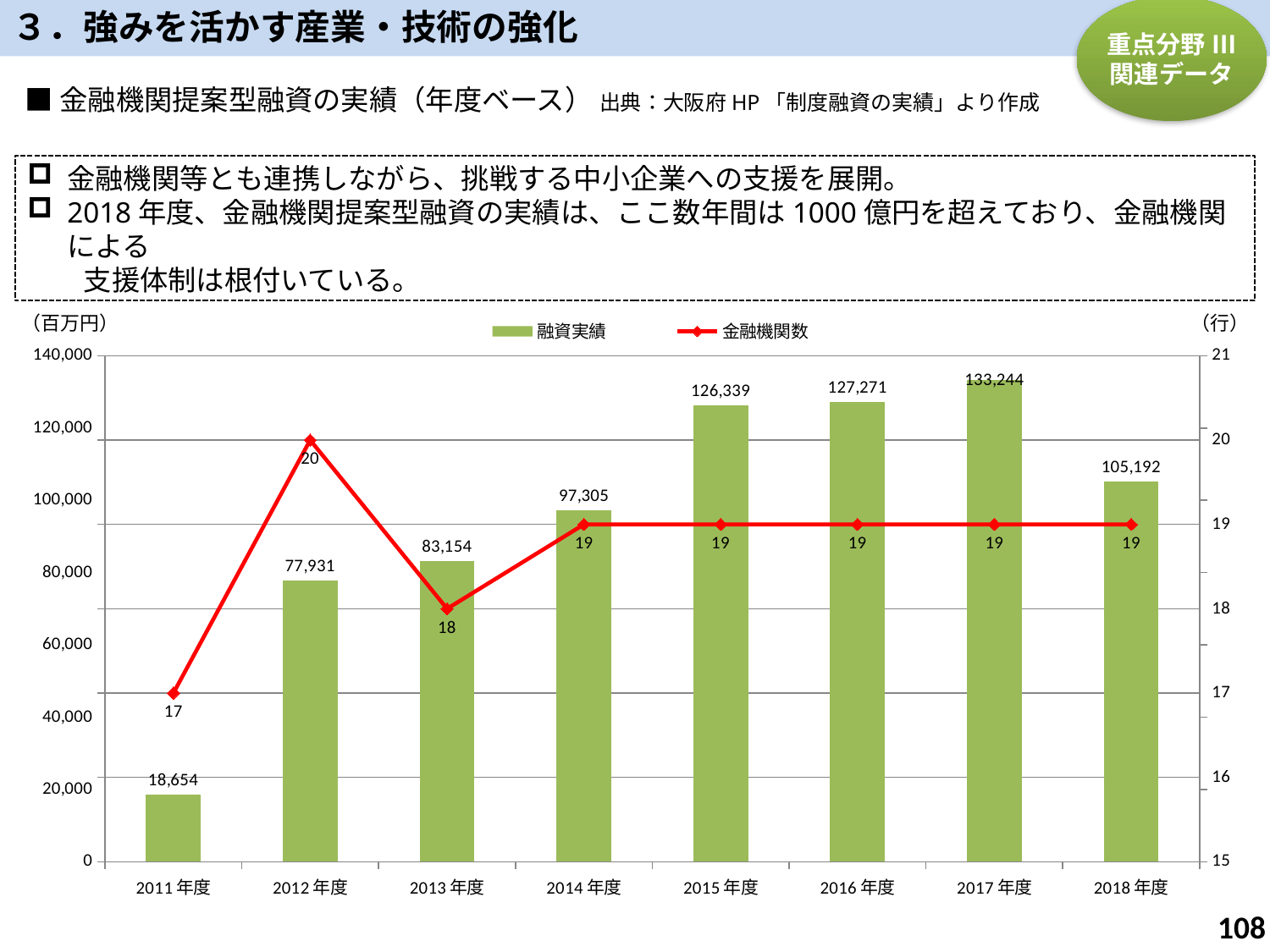
Which year has the lowest 融資実績? 2011年度 What is the 融資実績 value for 2018年度? 105,192 What is the 融資実績 value for 2014年度? 97,305 What is the unit shown on the left axis of the chart? 百万円 What kind of chart is shown on the slide? Combined bar and line chart What is the 金融機関数 value for 2012年度? 20 How many series does the legend list? 2 Which year has the lowest 金融機関数? 2011年度 How many fiscal years are shown on the x axis? 8 Which year has the highest 融資実績? 2017年度 Which is larger, the 融資実績 for 2013年度 or for 2014年度? 2014年度 What is the difference in 融資実績 between 2017年度 and 2018年度? 28,052